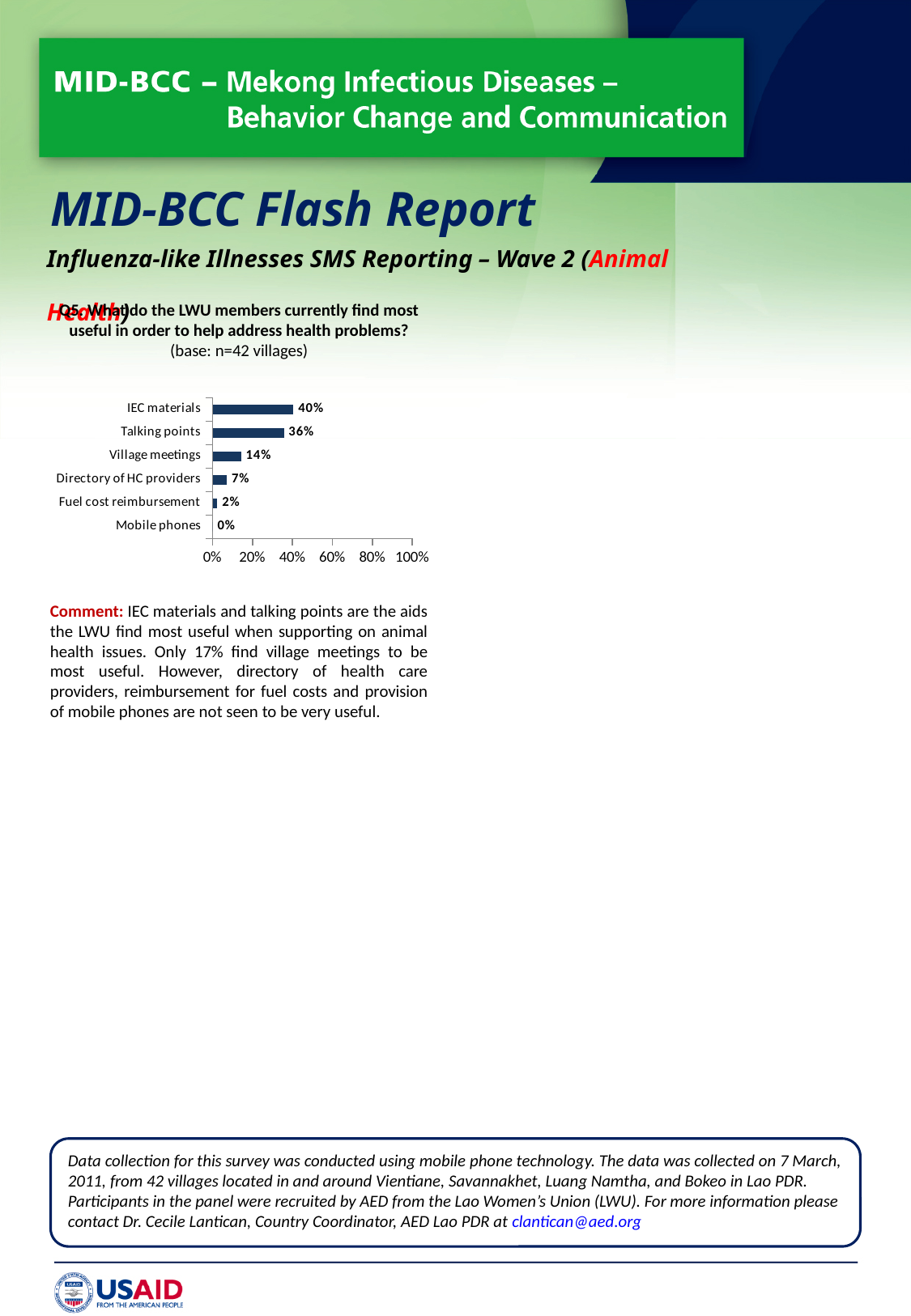
How many categories are shown in the chart? 6 What is the difference between the values for IEC materials and Talking points? 4% Which is larger, the value for Village meetings or the value for Fuel cost reimbursement? Village meetings What is the value shown for Talking points? 36% What percentage is shown for Mobile phones? 0% What is the base (number of villages) stated in the chart title? n=42 villages What percentage is shown for Village meetings? 14% What kind of chart is shown on the slide? Bar chart What is the value for Directory of HC providers? 7% Which category has the highest value in the chart? IEC materials Which category has the lowest value in the chart? Mobile phones What percentage of villages find IEC materials most useful? 40%